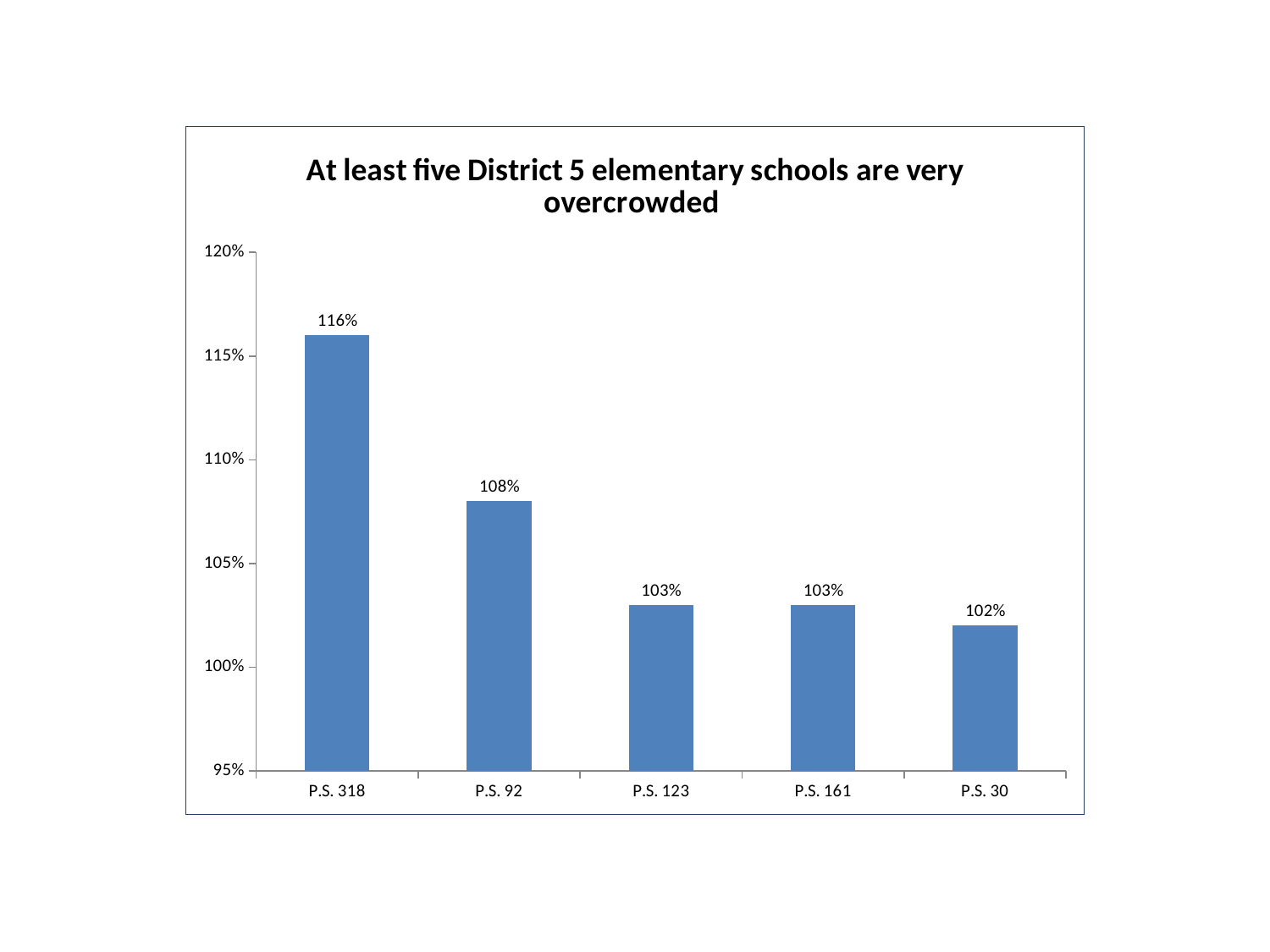
What is the value for P.S. 30? 102% What is the difference between the values for P.S. 318 and P.S. 92? 8% Which is larger, the value for P.S. 92 or the value for P.S. 123? P.S. 92 Which school has the lowest value? P.S. 30 What kind of chart is this? bar chart What is the value for P.S. 318? 116% How many schools are shown on the chart? 5 Which school has the highest value? P.S. 318 What is the difference between the values for P.S. 92 and P.S. 30? 6% Do the values rise or fall from left to right along the x axis? fall Is the value for P.S. 318 greater or less than 115%? greater What is the value for P.S. 92? 108%